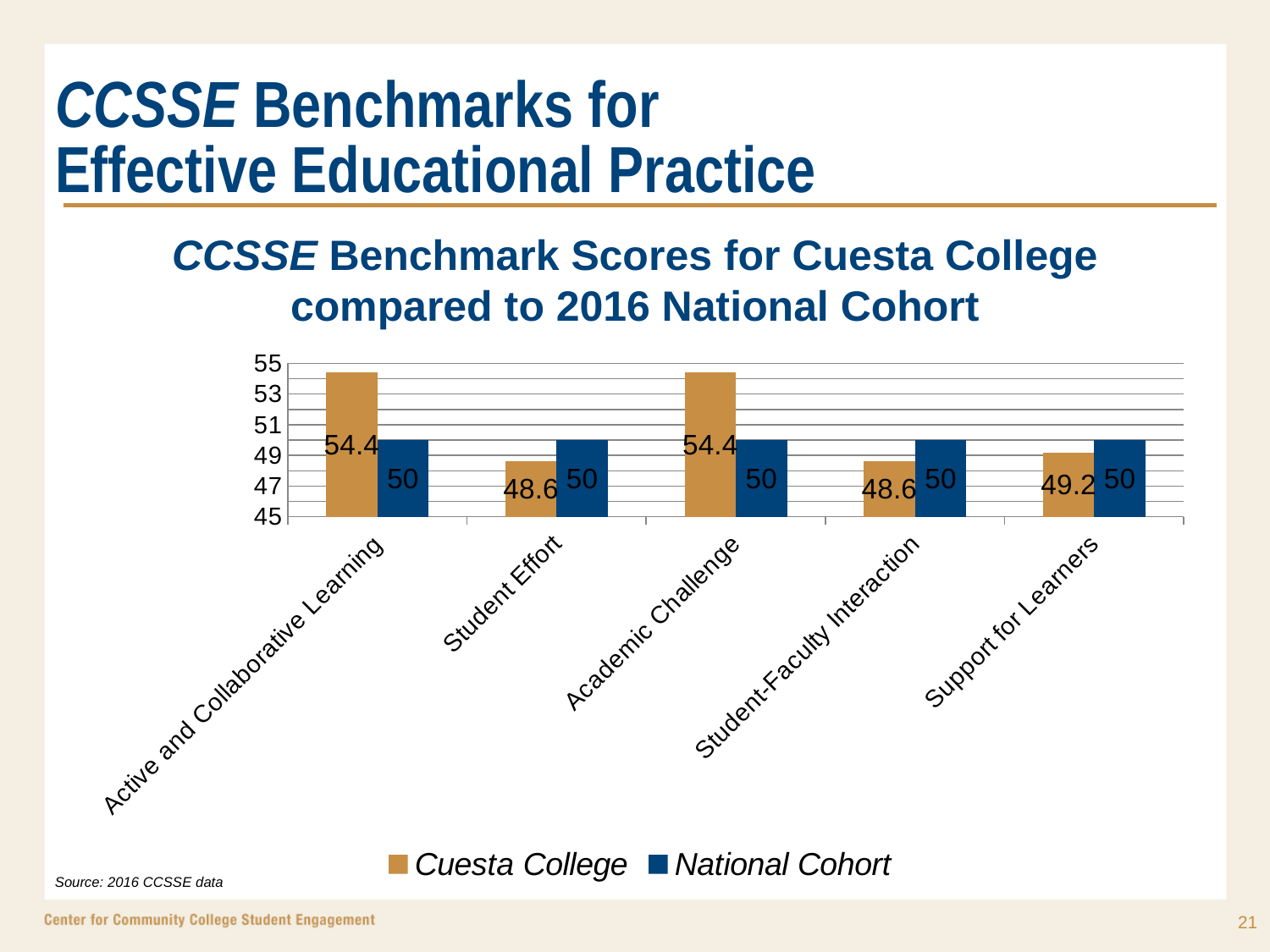
What is the difference between the Cuesta College and National Cohort scores for Academic Challenge? 4.4 What is the Cuesta College score for Active and Collaborative Learning? 54.4 Which benchmark has the lowest Cuesta College score? Student Effort and Student-Faculty Interaction (both 48.6) How many benchmark categories are shown on the x axis? 5 What kind of chart is shown on the slide? Bar chart For Student-Faculty Interaction, which is larger: the Cuesta College score or the National Cohort score? National Cohort How many series does the legend list? 2 What is the difference between the National Cohort and Cuesta College scores for Support for Learners? 0.8 What is the Cuesta College score for Support for Learners? 49.2 What is the Cuesta College score for Student Effort? 48.6 What is the National Cohort score for Academic Challenge? 50 For Active and Collaborative Learning, which is larger: the Cuesta College score or the National Cohort score? Cuesta College